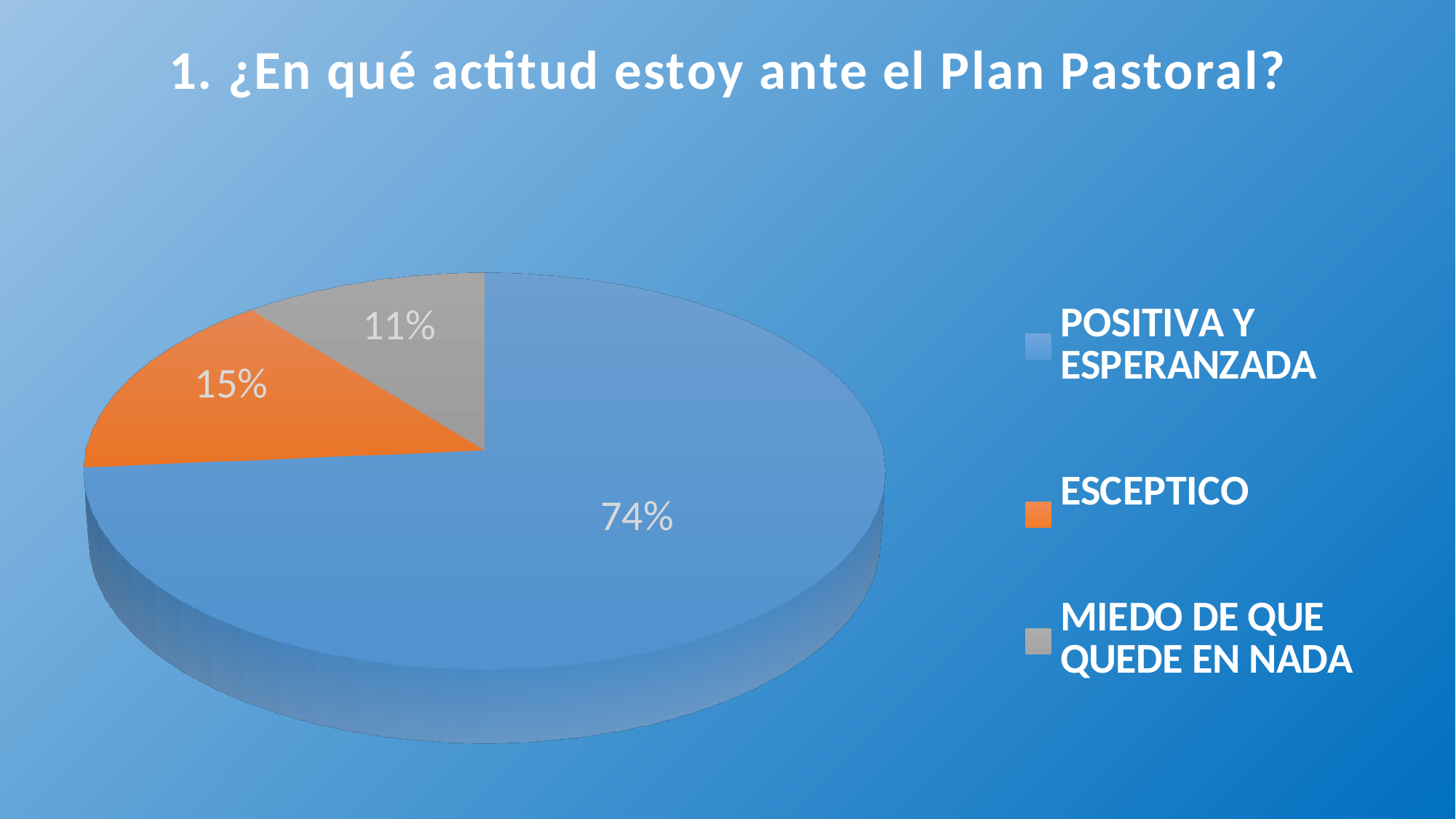
What is the value shown for MIEDO DE QUE QUEDE EN NADA? 11% Which is larger, the ESCEPTICO slice or the MIEDO DE QUE QUEDE EN NADA slice? ESCEPTICO How many categories are shown in the pie chart? 3 What is the difference between the ESCEPTICO share and the MIEDO DE QUE QUEDE EN NADA share? 4% Which colour represents ESCEPTICO in the legend? Orange Which category has the largest slice of the pie? POSITIVA Y ESPERANZADA What share of the pie does POSITIVA Y ESPERANZADA represent? 74% Which category has the smallest slice of the pie? MIEDO DE QUE QUEDE EN NADA What kind of chart is shown on the slide? Pie chart What is the difference between the POSITIVA Y ESPERANZADA share and the ESCEPTICO share? 59% What is the title of the chart? 1. ¿En qué actitud estoy ante el Plan Pastoral? What is the value shown for ESCEPTICO? 15%